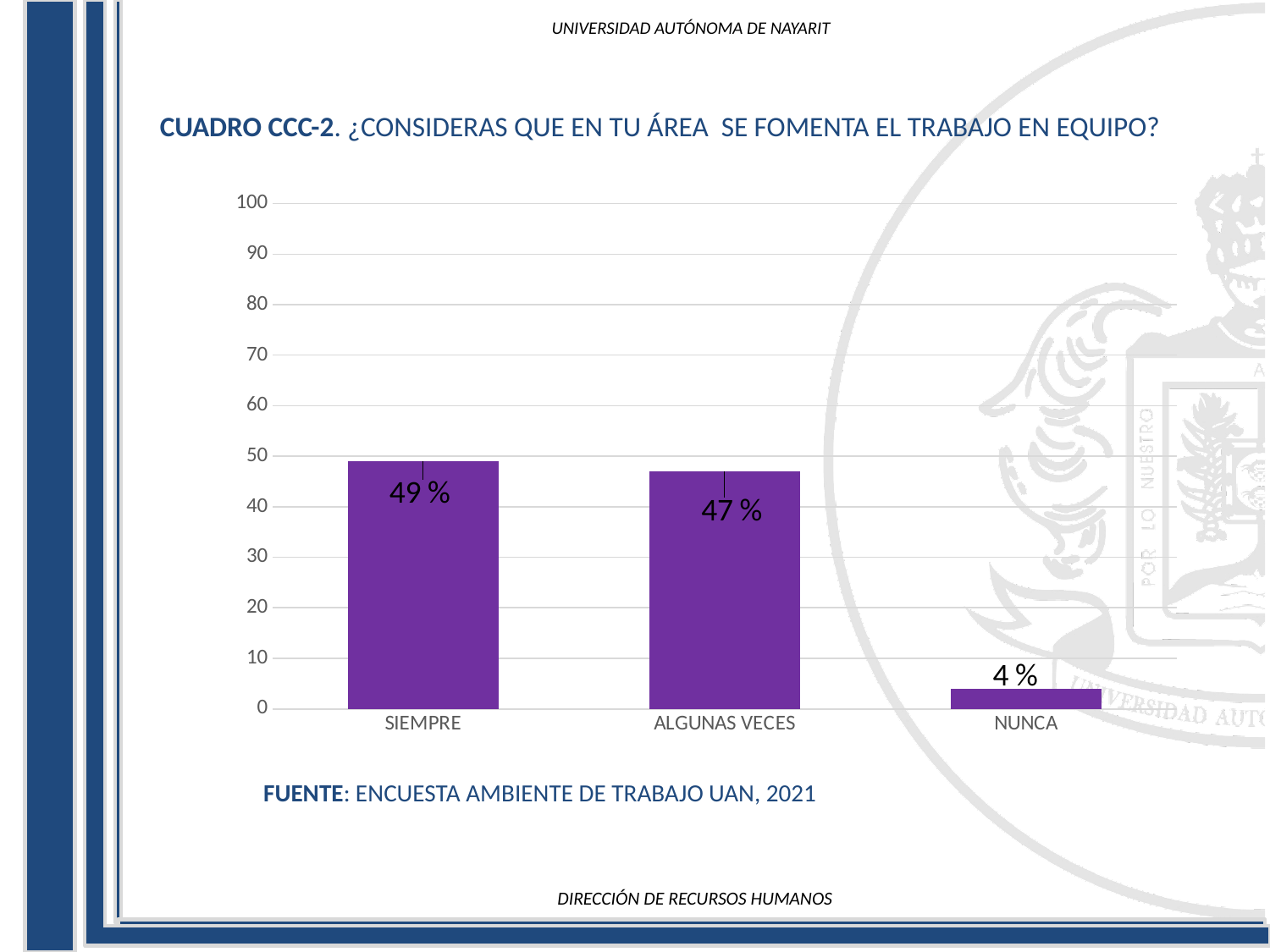
What kind of chart is shown on the slide? bar chart What is the value for ALGUNAS VECES? 47 % Which category has the lowest value? NUNCA How many categories are shown on the x axis? 3 Which category has the highest value? SIEMPRE What is the difference between the values for ALGUNAS VECES and NUNCA? 43 % Is the value for SIEMPRE greater or less than 40? greater What is the difference between the values for SIEMPRE and ALGUNAS VECES? 2 % What is the value for NUNCA? 4 % What is the source cited below the chart? ENCUESTA AMBIENTE DE TRABAJO UAN, 2021 What is the value for SIEMPRE? 49 % Which is larger, the value for ALGUNAS VECES or the value for NUNCA? ALGUNAS VECES